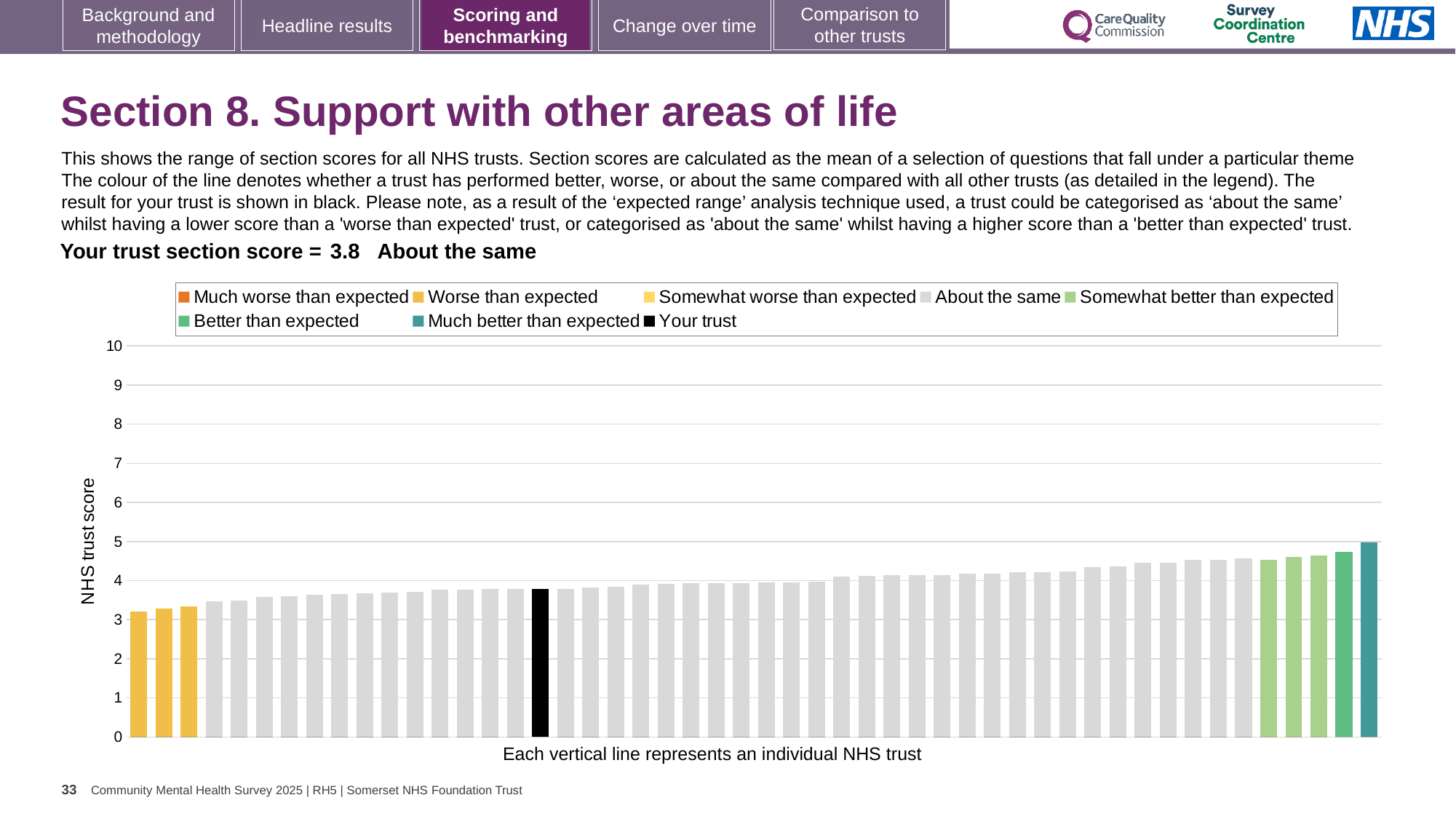
Is the value of the tallest bar greater or less than 6? less Is the value of the shortest bar greater or less than 3? greater What colour is the bar representing your trust? Black Do the bar values rise or fall from left to right along the x axis? Rise How many bars are coloured as 'Somewhat better than expected'? 3 What kind of chart is shown on the slide? Bar chart How many entries does the chart legend list? 8 What is the section score for your trust shown on the slide? 3.8 How many bars are coloured as 'Worse than expected'? 3 What is the label on the vertical axis of the chart? NHS trust score Is the value of the tallest bar greater or less than 4? greater